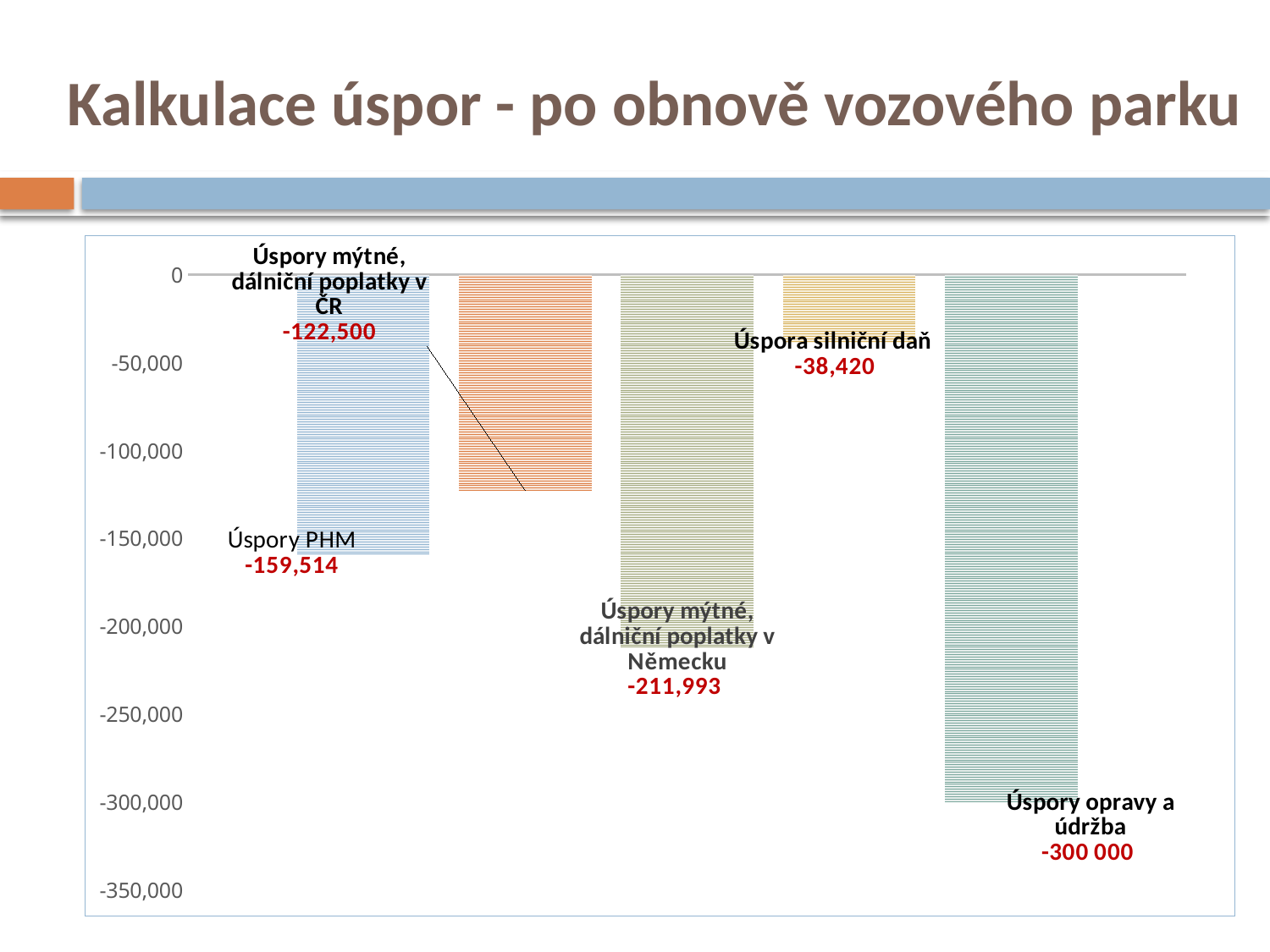
What is the difference between the values for Úspory mýtné, dálniční poplatky v Německu and Úspory mýtné, dálniční poplatky v ČR? 89,493 Which has the larger value, Úspory PHM or Úspory mýtné, dálniční poplatky v ČR? Úspory mýtné, dálniční poplatky v ČR What is the title of the slide containing the chart? Kalkulace úspor - po obnově vozového parku Which category has the highest value (the bar closest to zero)? Úspora silniční daň What kind of chart is shown on the slide? Bar chart What is the value shown for Úspory PHM? -159,514 Which category has the lowest value (the bar extending furthest below zero)? Úspory opravy a údržba What is the value shown for Úspora silniční daň? -38,420 What is the value shown for Úspory mýtné, dálniční poplatky v Německu? -211,993 How many bars are plotted in the chart? 5 What is the value shown for Úspory mýtné, dálniční poplatky v ČR? -122,500 What is the value shown for Úspory opravy a údržba? -300 000